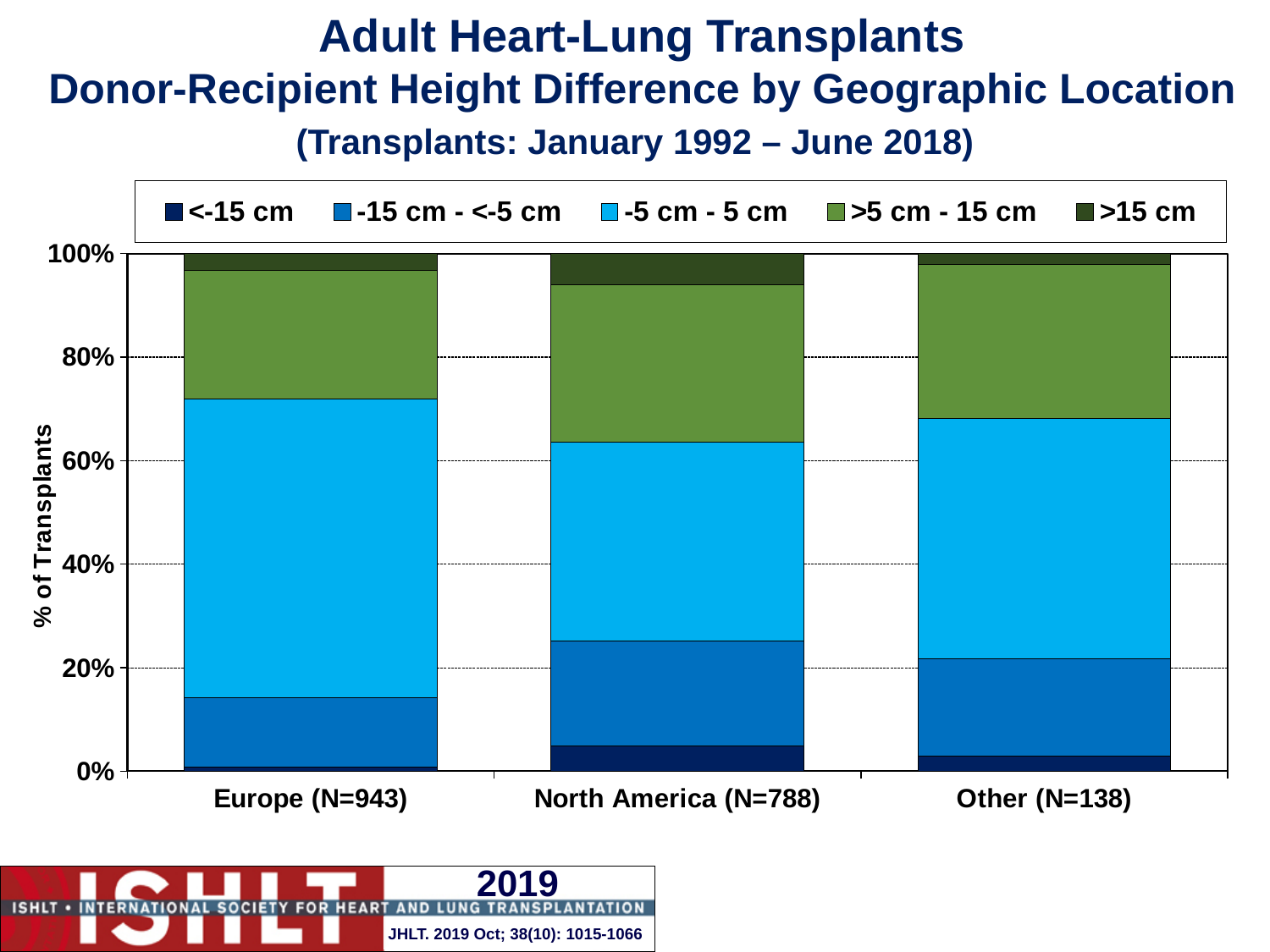
What kind of chart is shown on the slide? Stacked bar chart Is the share of transplants in the -5 cm - 5 cm category for Europe greater or less than 40%? greater What is the label of the y axis? % of Transplants How many height-difference series does the legend list? 5 Which geographic location has the smallest share of transplants in the -5 cm - 5 cm category? North America (N=788) How many geographic location categories are shown on the x axis? 3 What is the number of transplants (N) shown for Europe? 943 Is the share of transplants in the -5 cm - 5 cm category for Other greater or less than 60%? less Which has a larger share of transplants in the >15 cm category, North America or Other? North America (N=788) Which geographic location has the largest share of transplants in the <-15 cm category? North America (N=788) Which geographic location has the largest share of transplants in the -5 cm - 5 cm category? Europe (N=943) Which has a larger share of transplants in the -15 cm - <-5 cm category, Europe or North America? North America (N=788)